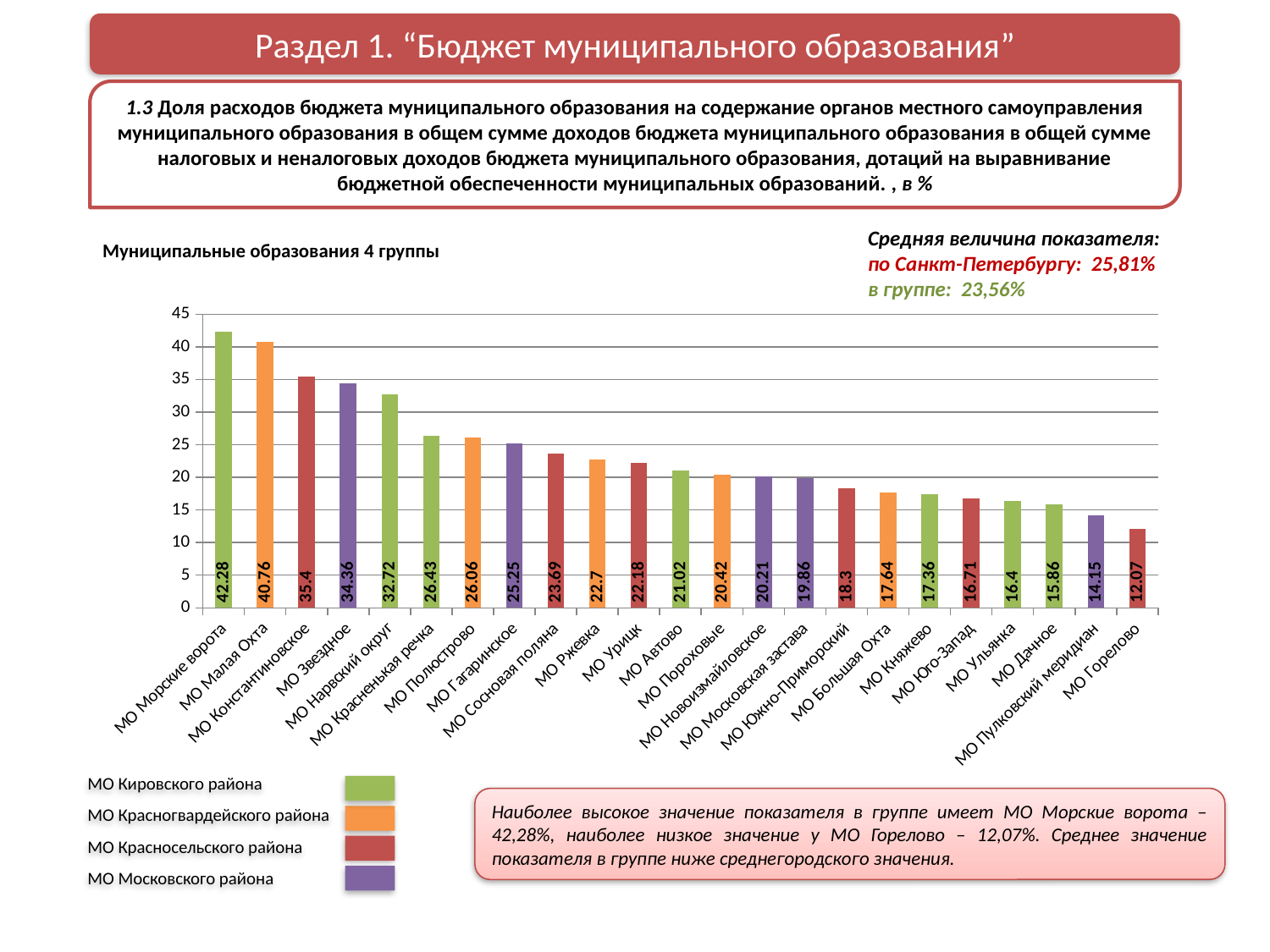
Which municipality has the lowest value in the chart? МО Горелово Which municipality has the highest value in the chart? МО Морские ворота Which has a larger value, МО Малая Охта or МО Константиновское? МО Малая Охта What is the difference between the values for МО Морские ворота and МО Горелово? 30.21 What is the value for МО Гагаринское? 25.25 What is the value for МО Морские ворота? 42.28 Do the values rise or fall from left to right along the x axis? fall How many municipalities are shown in the chart? 23 Is the value for МО Нарвский округ greater or less than 30? greater What type of chart is shown on the slide? bar chart How many entries does the legend list? 4 What is the value for МО Пулковский меридиан? 14.15